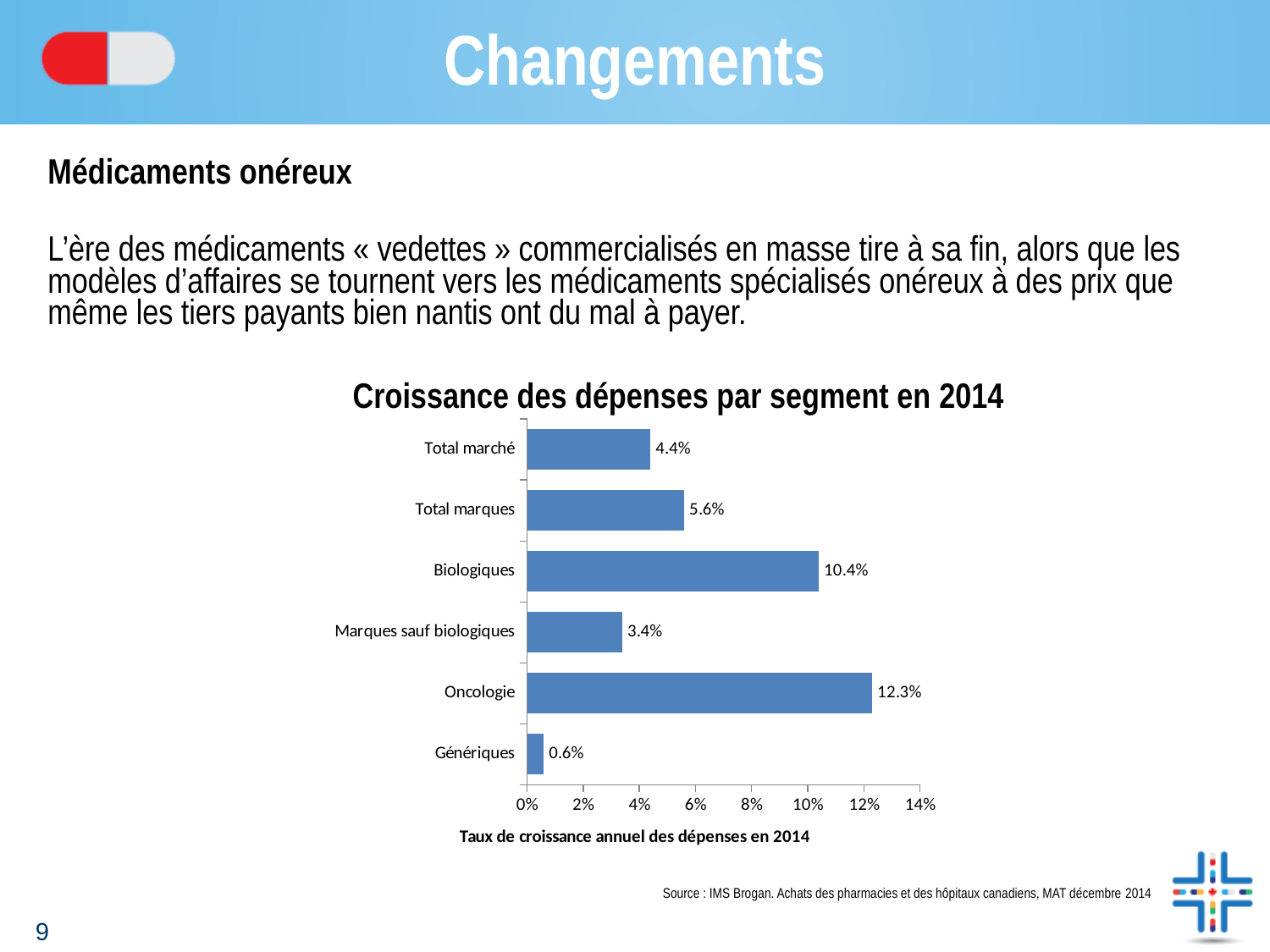
What is the difference between the growth rates of Oncologie and Biologiques? 1.9% What kind of chart is shown on the slide? Bar chart Which has a higher growth rate, Total marques or Total marché? Total marques What is the title of the chart? Croissance des dépenses par segment en 2014 What is the difference between the growth rates of Total marques and Marques sauf biologiques? 2.2% How many segments are shown in the chart? 6 Which segment has the highest growth rate? Oncologie What is the growth rate shown for Oncologie? 12.3% What is the growth rate shown for Total marché? 4.4% What is the growth rate shown for Biologiques? 10.4% What is the growth rate shown for Génériques? 0.6% Which segment has the lowest growth rate? Génériques